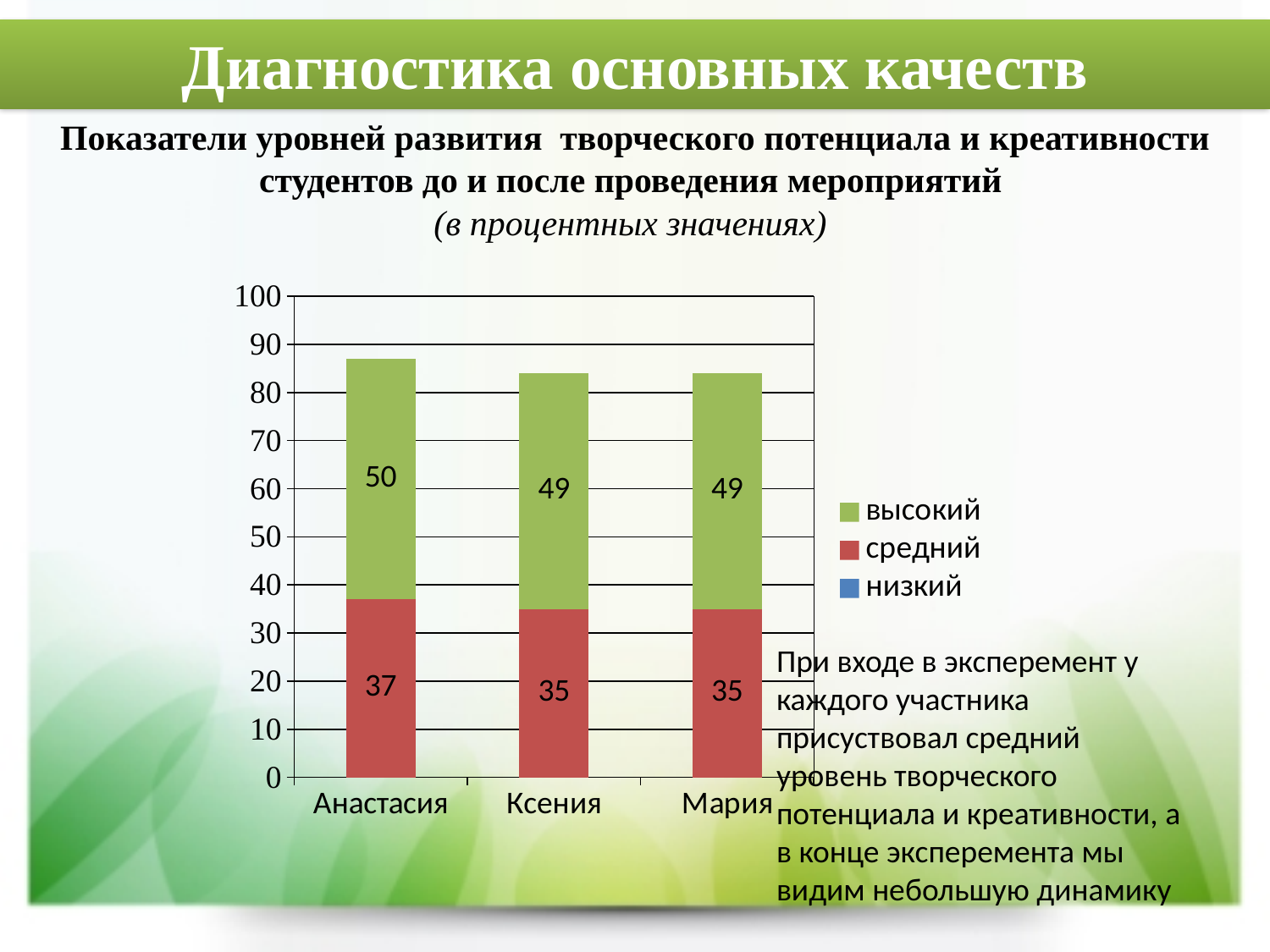
What is the value of the "средний" segment for Мария? 35 What is the difference between the "высокий" and "средний" values for Анастасия? 13 What is the value of the "высокий" segment for Анастасия? 50 How many series does the legend list? 3 How many categories are shown on the x axis? 3 What is the total of the stacked bar for Анастасия? 87 Which category has the highest "высокий" value? Анастасия What is the value of the "высокий" segment for Ксения? 49 Which is larger: the "средний" value for Анастасия or for Ксения? Анастасия What kind of chart is shown on the slide? Stacked bar chart What is the value of the "средний" segment for Анастасия? 37 Which legend entry is shown in green? высокий